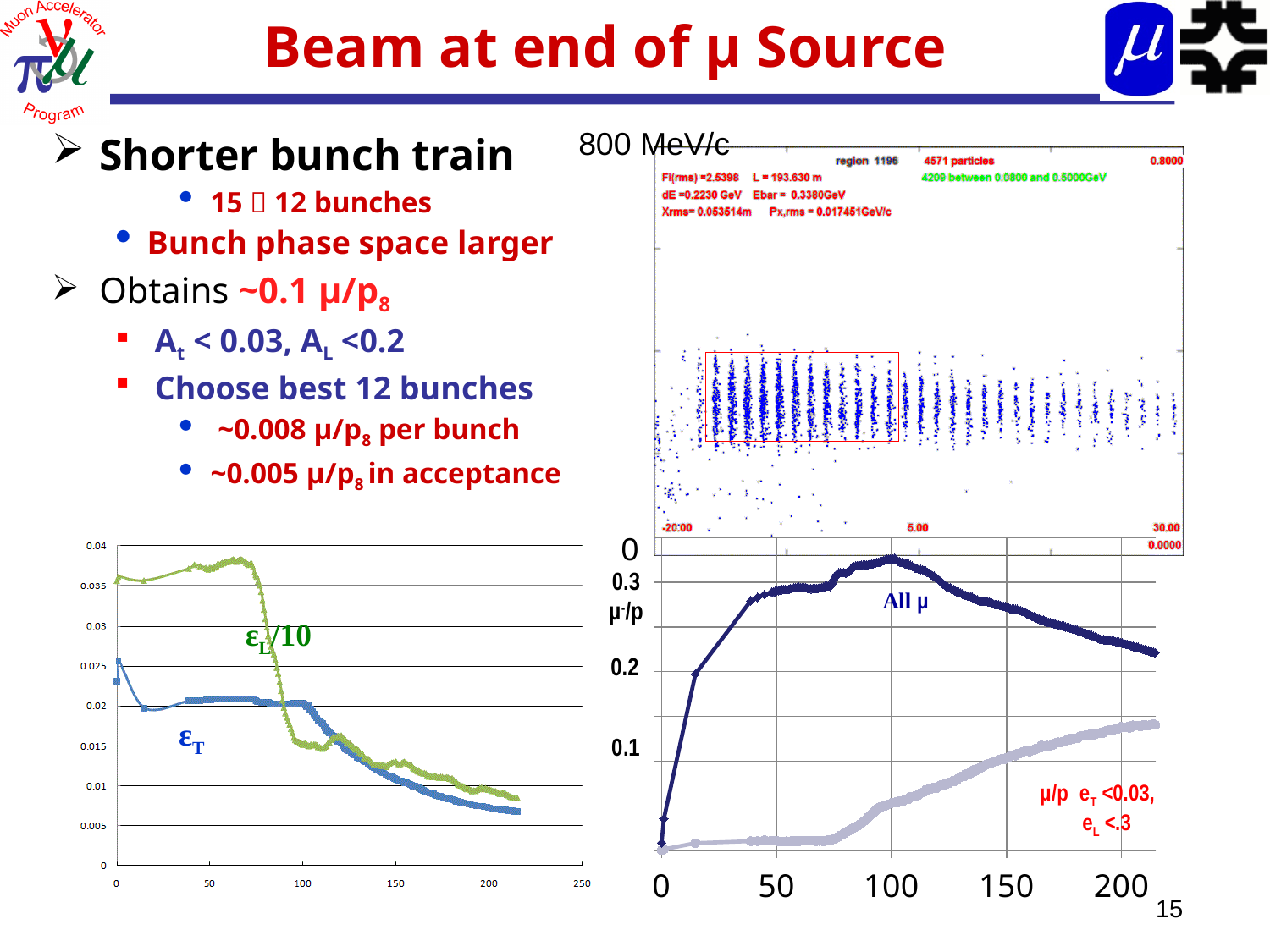
In the top-right scatter plot, what is the printed value of Ebar? 0.3380 GeV In the bottom-right chart, is the value of the 'μ/p eT<0.03, eL<.3' series at x = 50 greater or less than 0.1? less In the bottom-left chart, is the value of εL/10 at x = 50 greater or less than 0.035? greater In the bottom-right chart, is the 'All μ' value at x = 100 greater or less than 0.3? greater In the bottom-right chart, does the 'μ/p eT<0.03, eL<.3' series rise or fall as x increases from 100 to 200? rise In the bottom-left chart, do the εT and εL/10 values overall rise or fall as x increases from 0 to 200? fall In the top-right scatter plot, what value of L is printed in the annotation? 193.630 m What kind of chart is the bottom-left chart showing εT and εL/10? line chart In the top-right scatter plot, how many particles are reported in the annotation? 4571 particles What kind of chart is the top-right plot labelled 'region 1196'? scatter plot In the bottom-left chart, how many series are plotted? 2